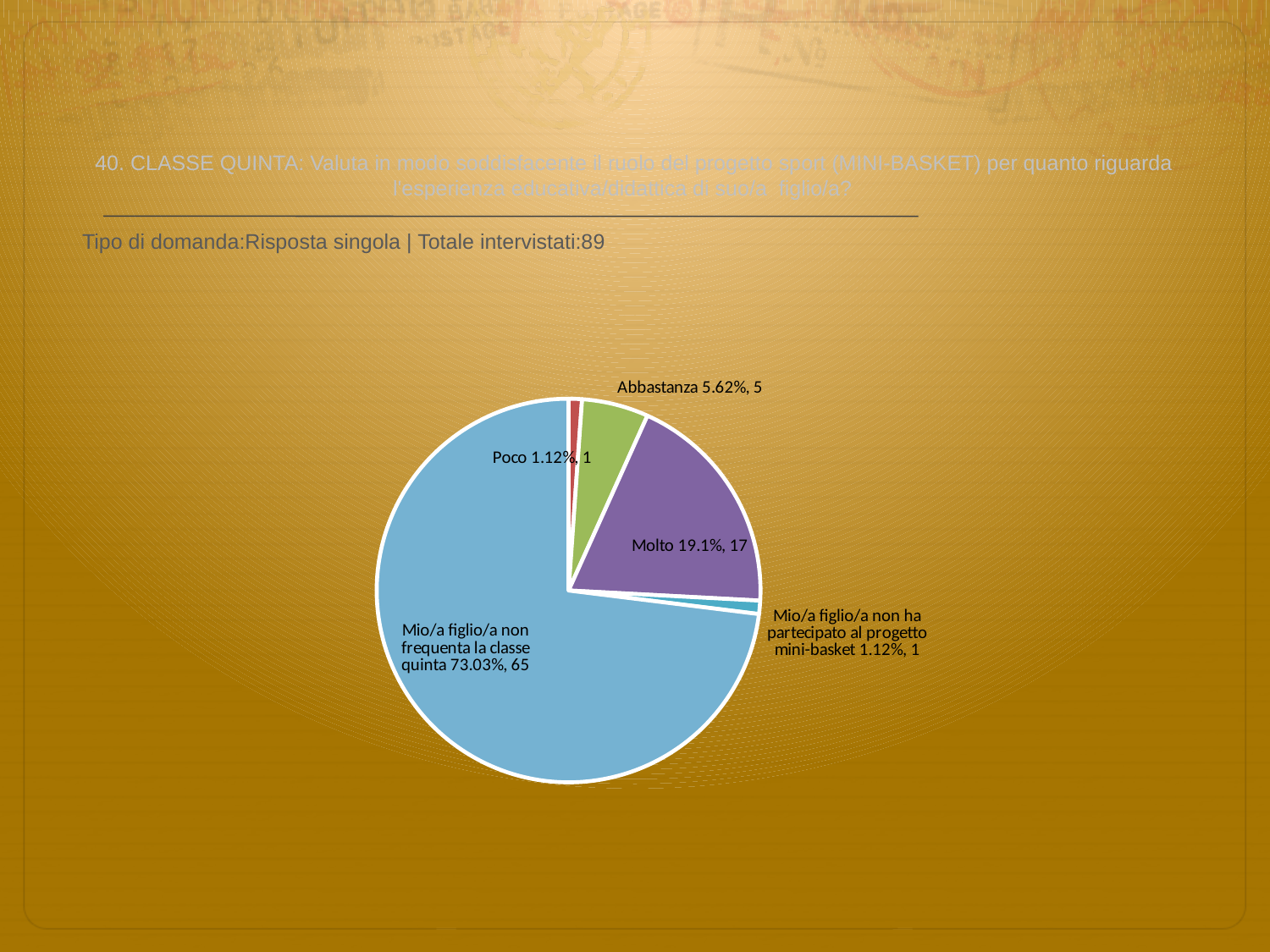
Which category has the largest slice of the pie? Mio/a figlio/a non frequenta la classe quinta What kind of chart is shown on the slide? pie chart What percentage share does the "Molto" slice have? 19.1% How many respondents answered "Abbastanza"? 5 What is the difference in respondent count between "Molto" and "Abbastanza"? 12 How many respondents answered "Poco"? 1 What percentage share does the "Mio/a figlio/a non frequenta la classe quinta" slice have? 73.03% How many slices does the pie chart have? 5 What is the total number of respondents shown on the slide? 89 What percentage share does the "Abbastanza" slice have? 5.62% Which slice is larger, "Molto" or "Abbastanza"? Molto How many respondents answered "Molto"? 17